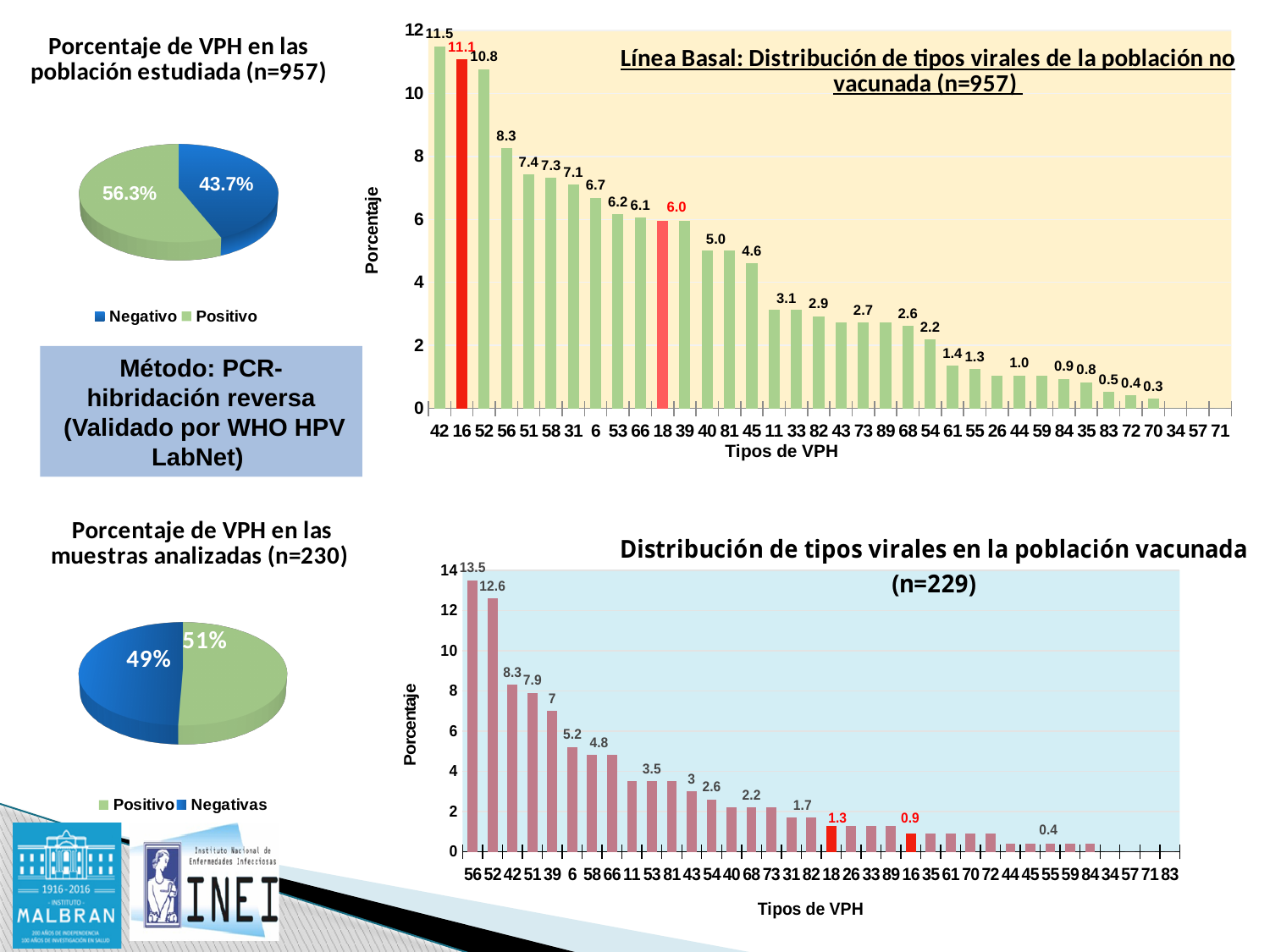
In the bar chart 'Distribución de tipos virales en la población vacunada (n=229)', is the value for type 52 greater or less than 12? greater In the bar chart 'Distribución de tipos virales en la población vacunada (n=229)', what is the value for type 16? 0.9 In the pie chart 'Porcentaje de VPH en las muestras analizadas (n=230)', which slice is larger, Positivo or Negativas? Positivo In the bar chart 'Distribución de tipos virales en la población vacunada (n=229)', what is the value for type 56? 13.5 What kind of chart is 'Distribución de tipos virales en la población vacunada (n=229)'? Bar chart In the bar chart 'Línea Basal: Distribución de tipos virales de la población no vacunada (n=957)', what is the difference between the values for type 42 and type 52? 0.7 In the bar chart 'Línea Basal: Distribución de tipos virales de la población no vacunada (n=957)', what is the value for type 42? 11.5 In the bar chart 'Línea Basal: Distribución de tipos virales de la población no vacunada (n=957)', what is the value for type 16? 11.1 In the bar chart 'Línea Basal: Distribución de tipos virales de la población no vacunada (n=957)', which VPH type has the highest percentage? 42 In the pie chart 'Porcentaje de VPH en las población estudiada (n=957)', what percentage is Negativo? 43.7% In the pie chart 'Porcentaje de VPH en las muestras analizadas (n=230)', what percentage is Positivo? 51% In the pie chart 'Porcentaje de VPH en las población estudiada (n=957)', what percentage is Positivo? 56.3%